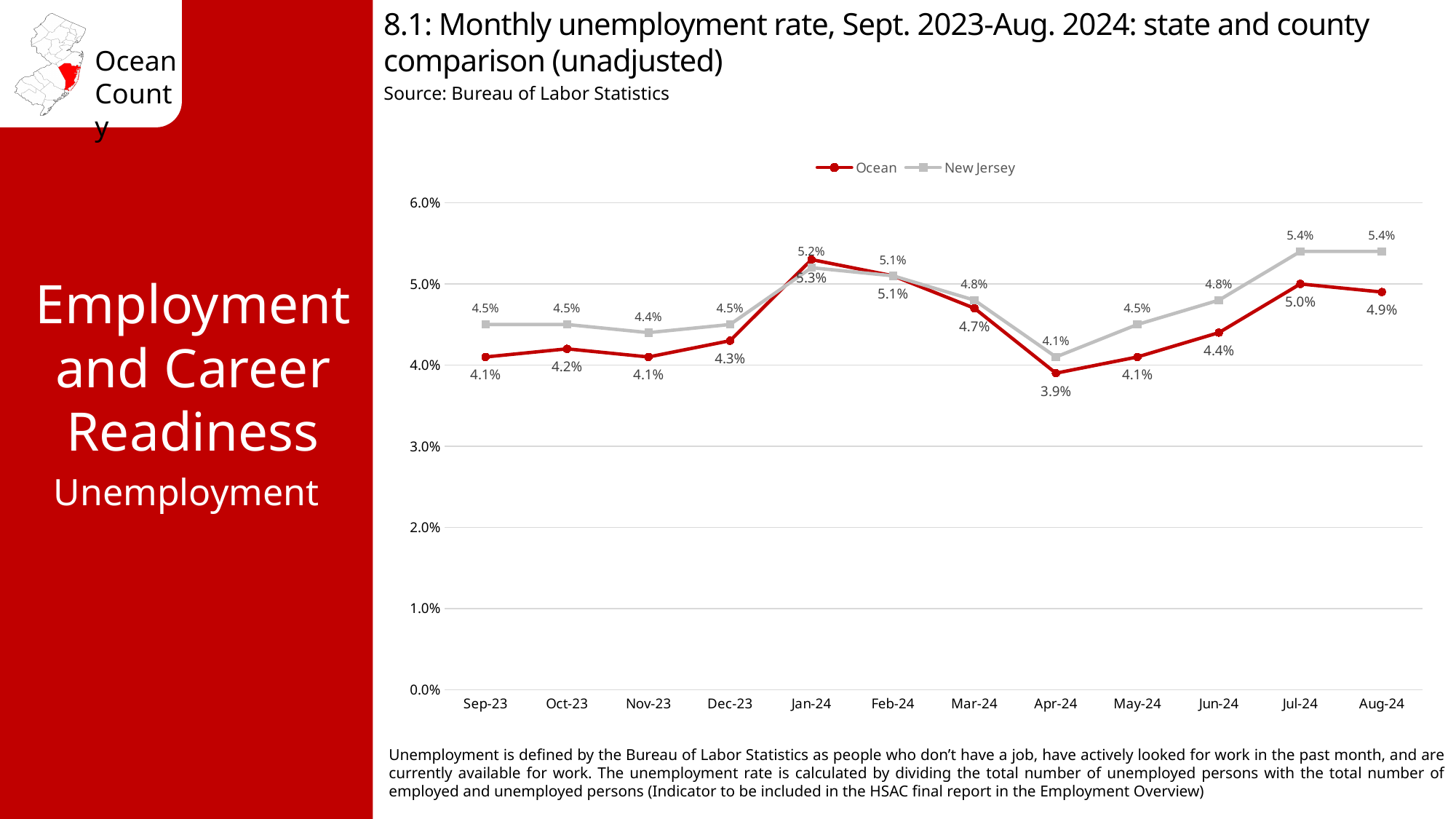
What was the unemployment rate for New Jersey in Jul-24? 5.4% What is the difference between the New Jersey and Ocean unemployment rates in Jun-24? 0.4% What type of chart is shown on the slide? Line chart What was the unemployment rate for Ocean in Aug-24? 4.9% Did the Ocean unemployment rate rise or fall from Jul-24 to Aug-24? Fall How many series does the legend list? 2 In which month was the Ocean unemployment rate lowest? Apr-24 How many months are plotted along the x axis? 12 What was the unemployment rate for Ocean in Apr-24? 3.9% Which was higher in May-24, the Ocean rate or the New Jersey rate? New Jersey In which month was the Ocean unemployment rate highest? Jan-24 What is the source cited for the chart? Bureau of Labor Statistics